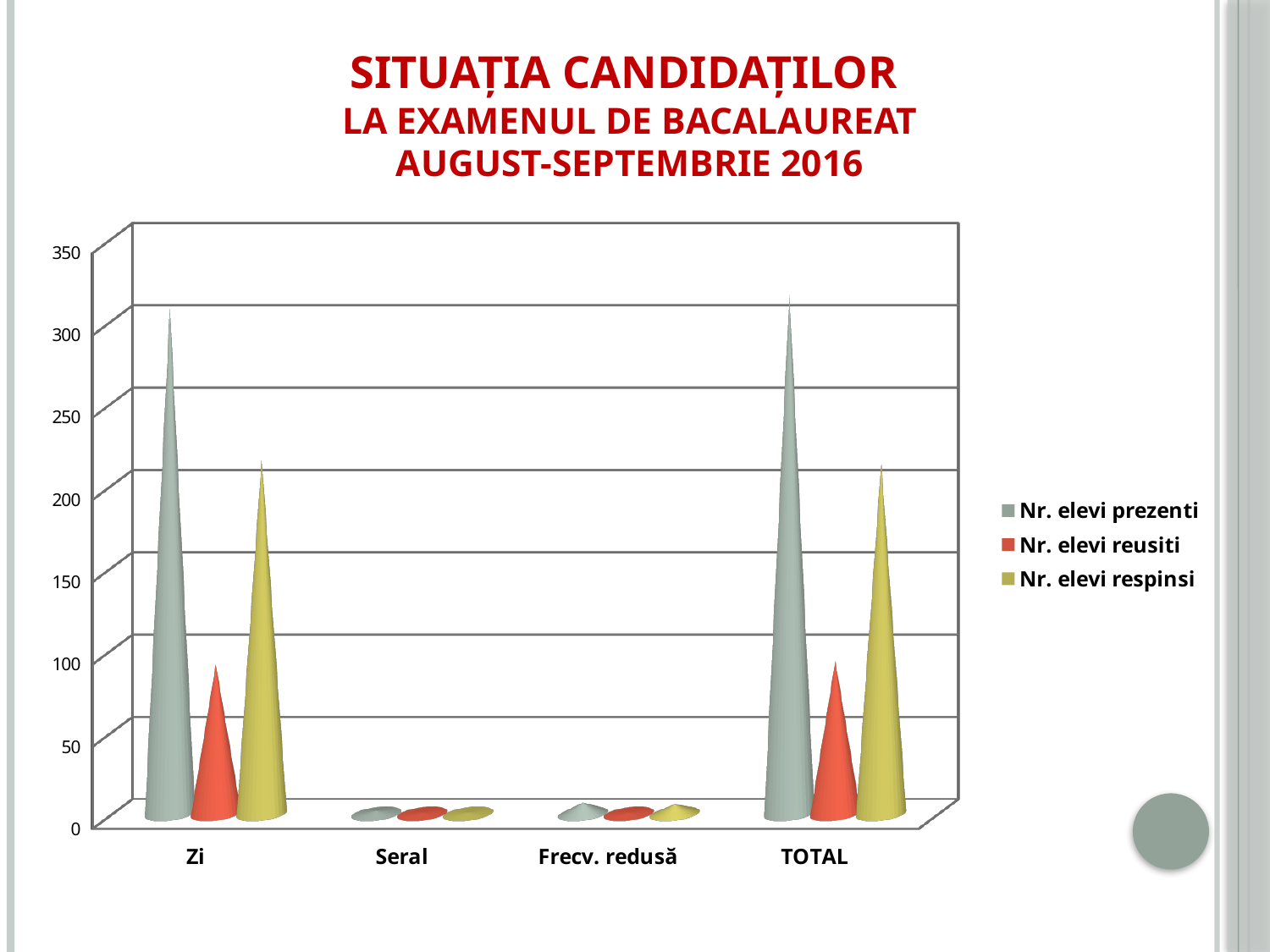
Is the value of Nr. elevi respinsi for Zi greater or less than 150? greater Is the value of Nr. elevi reusiti for Zi greater or less than 150? less How many series does the chart's legend list? 3 What kind of chart is shown on the slide? bar chart Is the value of Nr. elevi prezenti for Seral greater or less than 50? less For the TOTAL category, which is larger: Nr. elevi prezenti or Nr. elevi reusiti? Nr. elevi prezenti How many categories are shown on the x axis of the chart? 4 What is the label of the last category on the x axis of the chart? TOTAL Which series is shown in red in the chart's legend? Nr. elevi reusiti For the Zi category, which is larger: Nr. elevi reusiti or Nr. elevi respinsi? Nr. elevi respinsi